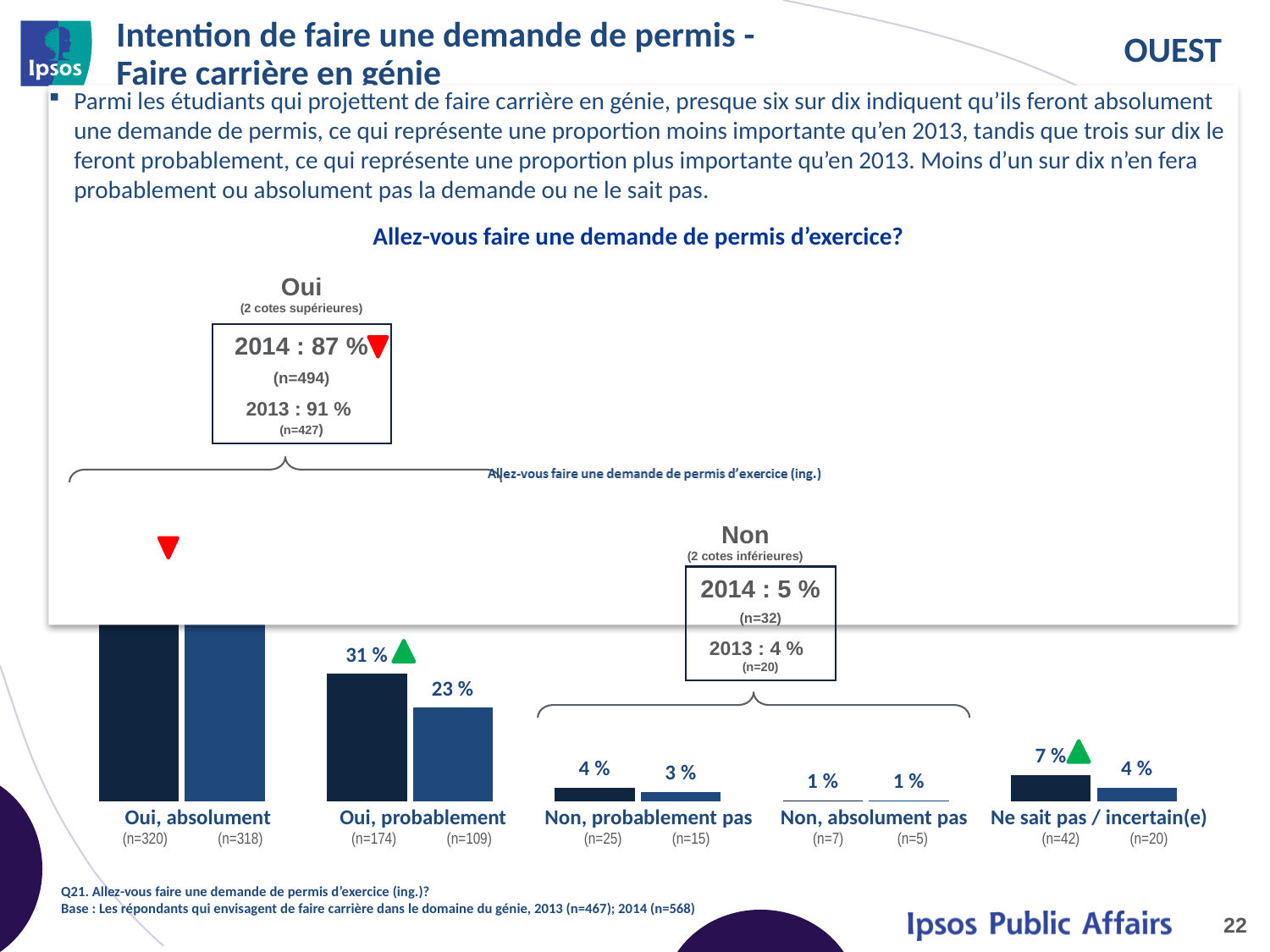
What is the 2014 percentage shown in the 'Oui (2 cotes supérieures)' summary box? 87 % In the 'Non, probablement pas' category, which bar is larger, the dark blue (2014) or the lighter blue (2013)? dark blue (2014) What value is shown for the lighter blue (2013) bar in the 'Ne sait pas / incertain(e)' category? 4 % What is the difference between the dark blue (2014) and lighter blue (2013) bars in the 'Ne sait pas / incertain(e)' category? 3 percentage points How many response categories are shown along the x axis of the chart? 5 What value is shown for both bars in the 'Non, absolument pas' category? 1 % What value is shown for the dark blue (2014) bar in the 'Oui, probablement' category? 31 % What value is shown for the dark blue (2014) bar in the 'Non, probablement pas' category? 4 % What is the difference between the dark blue (2014) and lighter blue (2013) bars in the 'Oui, probablement' category? 8 percentage points What kind of chart is shown on the slide? bar chart What value is shown for the lighter blue (2013) bar in the 'Oui, probablement' category? 23 % Which category has the tallest bars in the chart? Oui, absolument